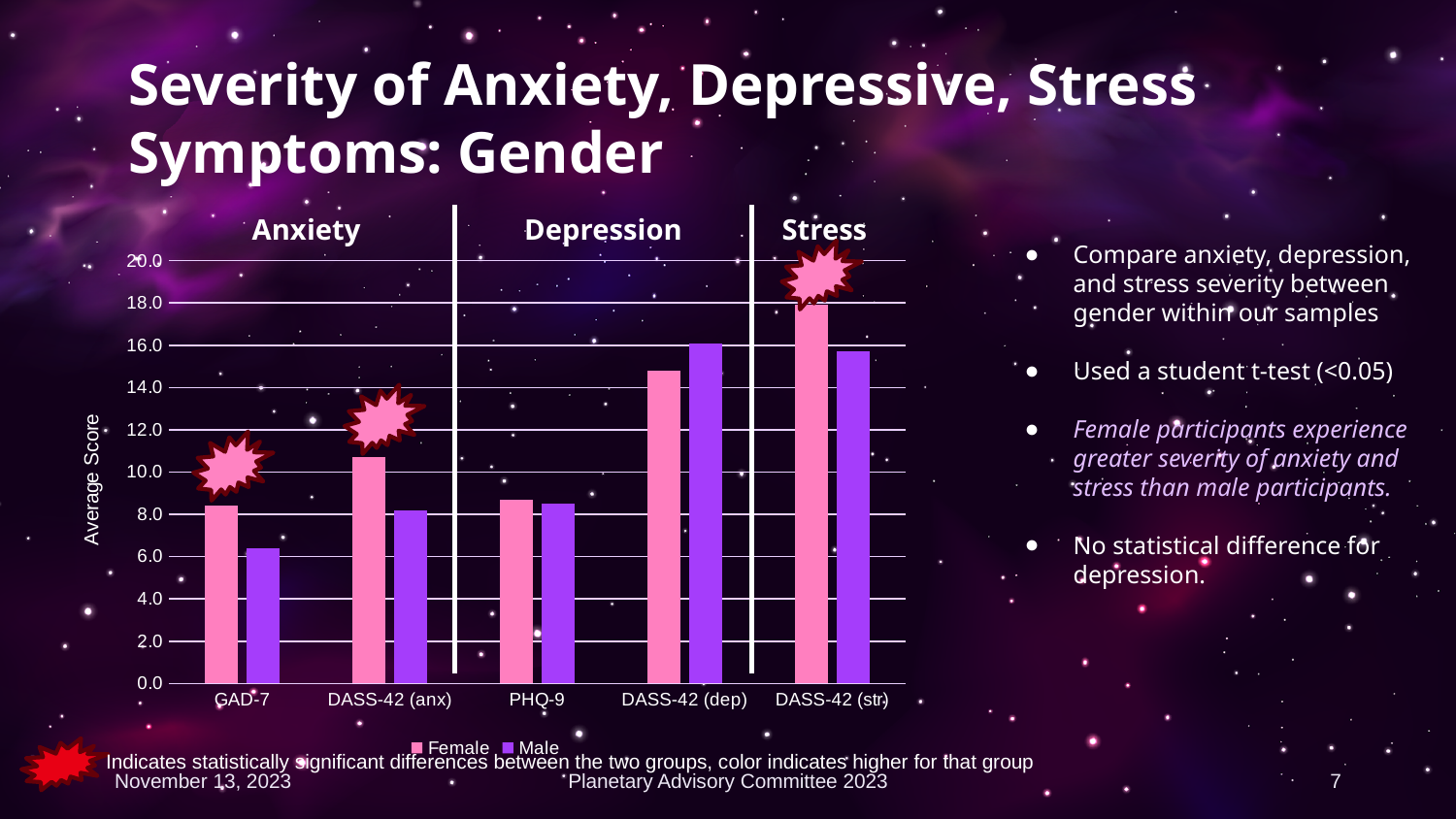
Is the Male value for GAD-7 greater or less than 8.0? less Is the Female value for DASS-42 (anx) greater or less than 10.0? greater What kind of chart is shown on the slide? bar chart How many categories are shown on the x axis of the chart? 5 What is the label on the chart's vertical axis? Average Score What are the two series named in the chart's legend? Female and Male Which category has the highest Female value? DASS-42 (str) How many series does the chart's legend list? 2 For DASS-42 (str), which series has the larger value, Female or Male? Female For DASS-42 (dep), which series has the larger value, Female or Male? Male